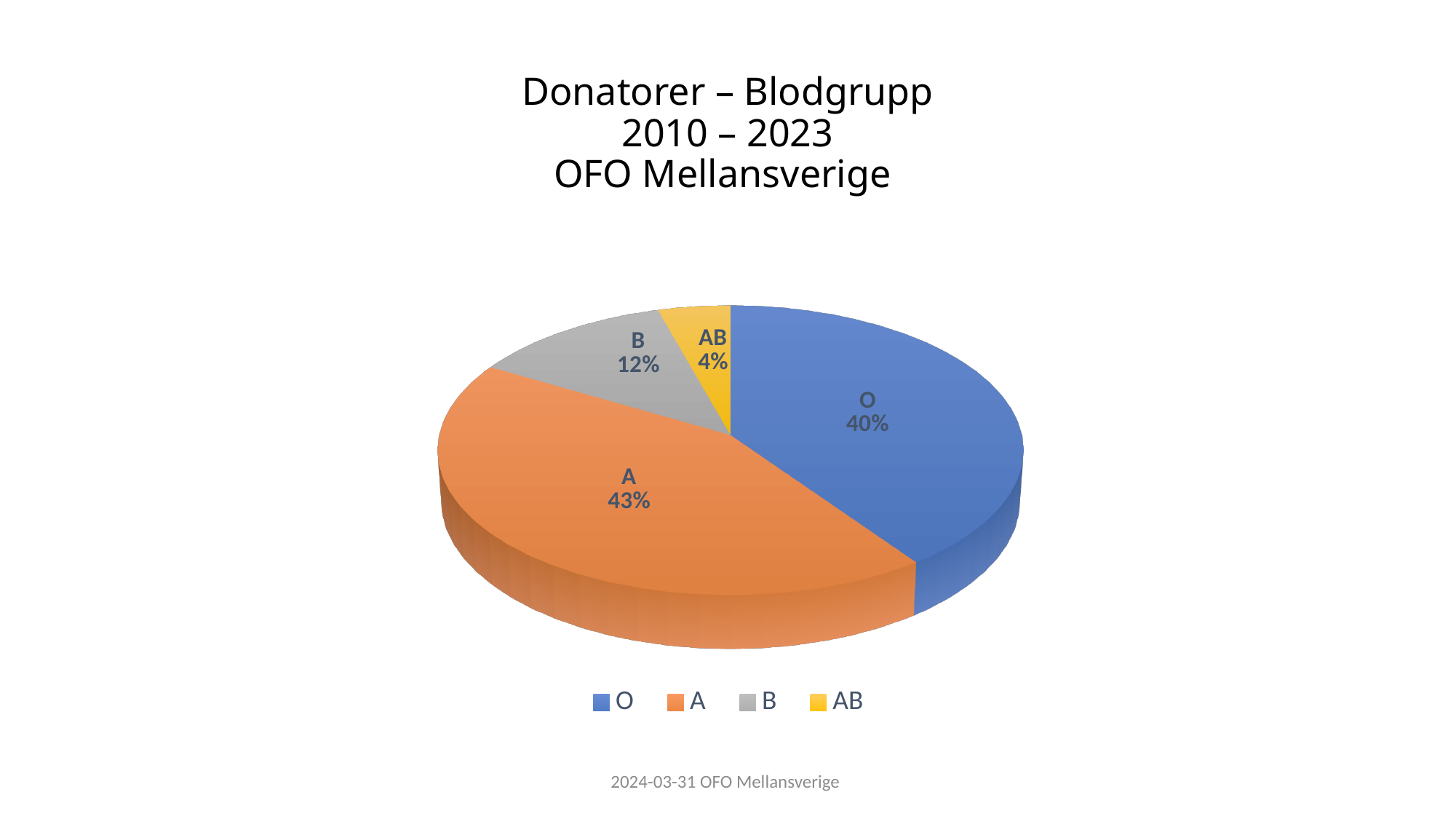
What share of donors has blood group AB? 4% What share of donors has blood group O? 40% What is the difference in percentage points between blood group B and blood group AB? 8% Which blood group has the smallest share of donors? AB How many blood groups are shown in the pie chart? 4 What type of chart is shown on the slide? Pie chart What is the title of the chart? Donatorer – Blodgrupp 2010 – 2023 OFO Mellansverige What share of donors has blood group A? 43% What is the difference in percentage points between blood group A and blood group O? 3% Which blood group has the largest share of donors? A Which has a larger share, blood group B or blood group AB? B What share of donors has blood group B? 12%